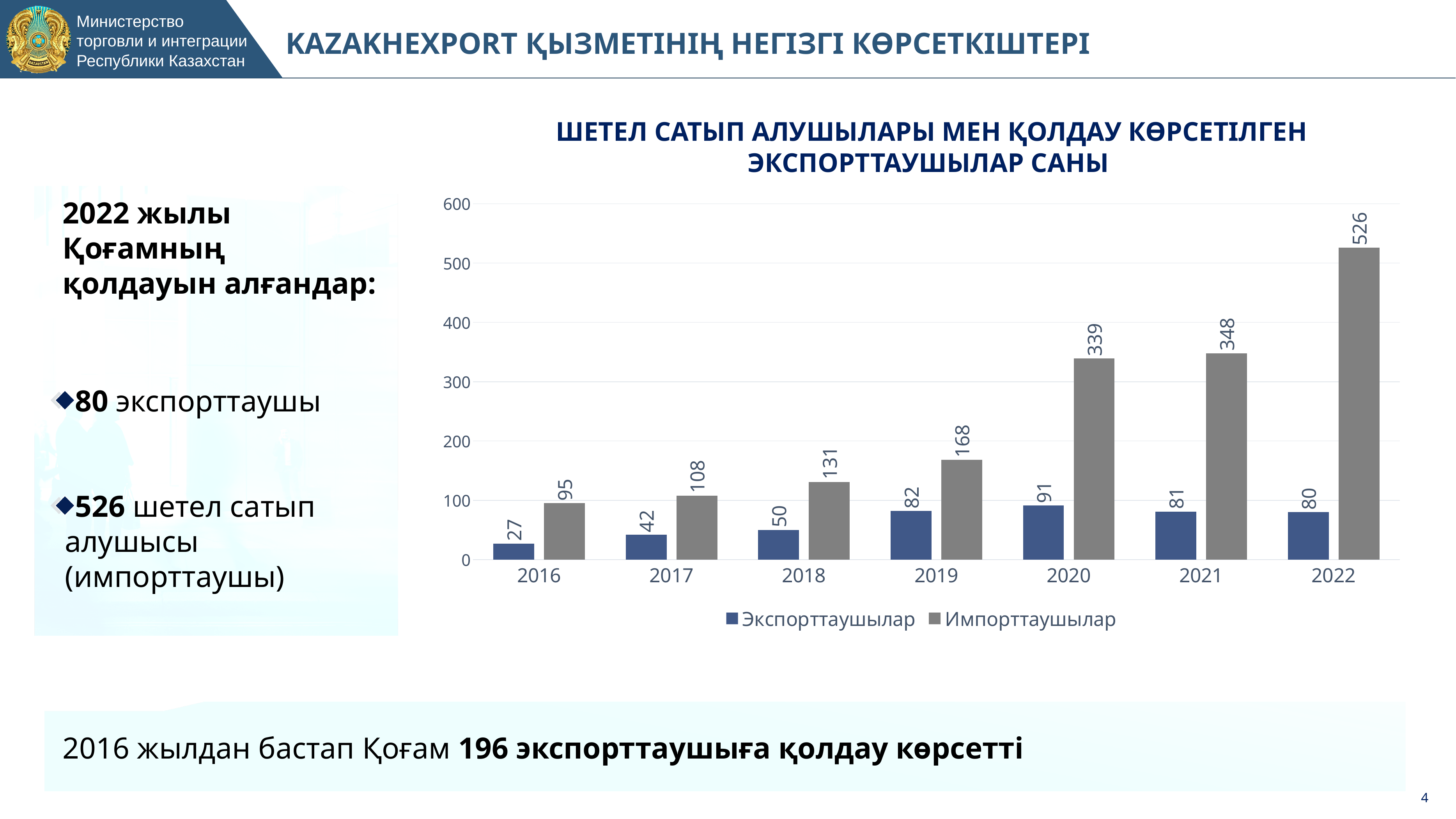
Which is larger: the Экспорттаушылар value in 2020 or in 2021? 2020 What kind of chart is shown on the slide? bar chart Do the Импорттаушылар values rise or fall from 2016 to 2022? rise What is the difference between the Импорттаушылар and Экспорттаушылар values in 2022? 446 Is the Импорттаушылар value for 2020 greater or less than 300? greater What is the value for Экспорттаушылар in 2019? 82 Which colour represents Экспорттаушылар in the legend? blue How many series does the legend list? 2 How many years are shown on the x axis? 7 In which year is the Экспорттаушылар value lowest? 2016 In which year is the Импорттаушылар value highest? 2022 What is the value for Импорттаушылар in 2021? 348